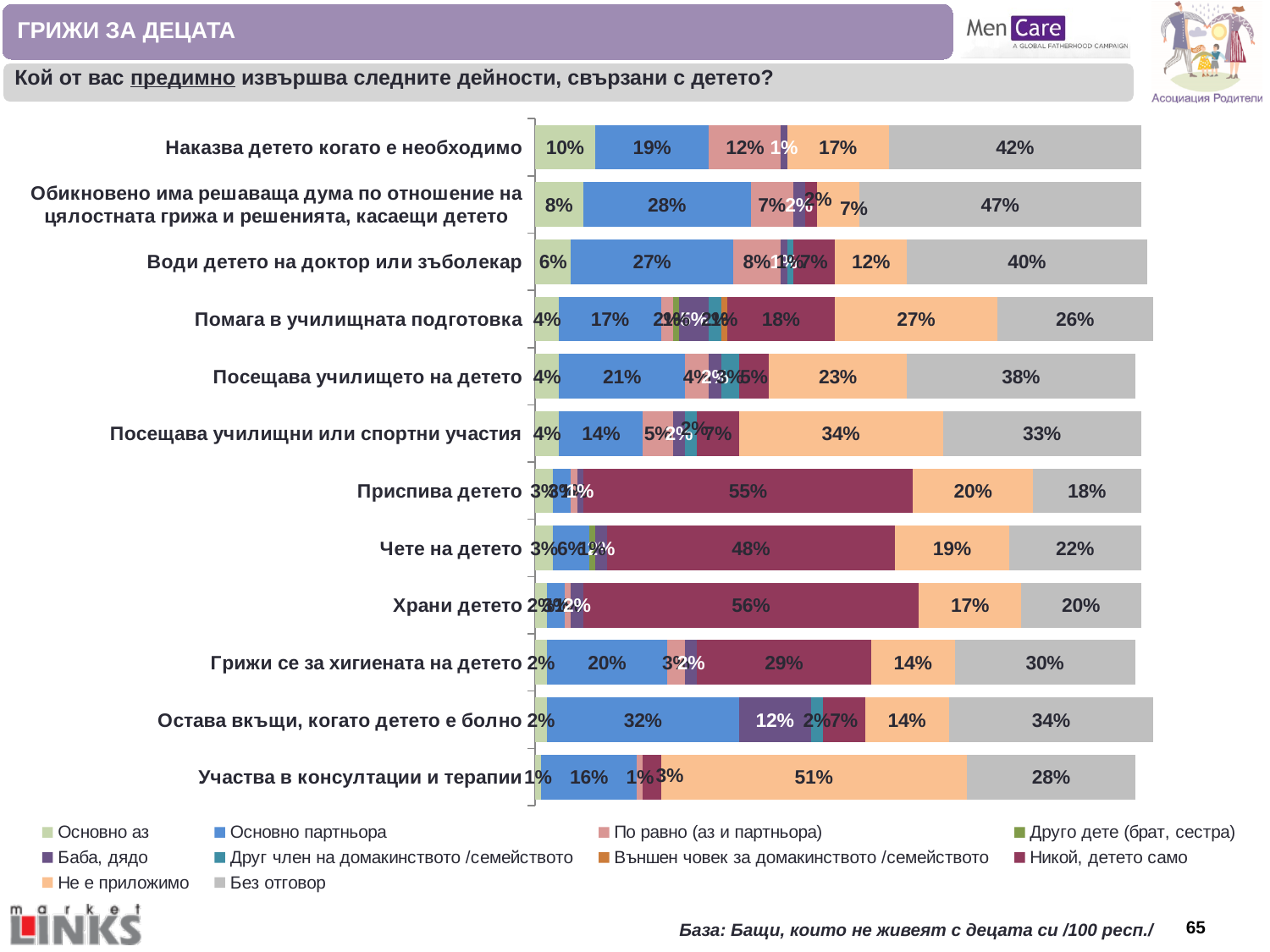
How many series does the legend list? 10 What kind of chart is shown on the slide? bar chart How many activity categories are plotted on the chart? 12 Which category has the highest value for "Не е приложимо"? Участва в консултации и терапии Which has the larger "Не е приложимо" value: "Посещава училищни или спортни участия" or "Посещава училището на детето"? Посещава училищни или спортни участия What is the value of "Не е приложимо" for "Участва в консултации и терапии"? 51% What is the value of "Никой, детето само" for "Храни детето"? 56% What is the value of "Основно аз" for "Наказва детето когато е необходимо"? 10% What is the value of "Основно партньора" for "Остава вкъщи, когато детето е болно"? 32% Which category has the highest value for "Без отговор"? Обикновено има решаваща дума по отношение на цялостната грижа и решенията, касаещи детето What is the value of "Без отговор" for "Наказва детето когато е необходимо"? 42% For "Наказва детето когато е необходимо", what is the difference between the "Основно партньора" value and the "Основно аз" value? 9 percentage points